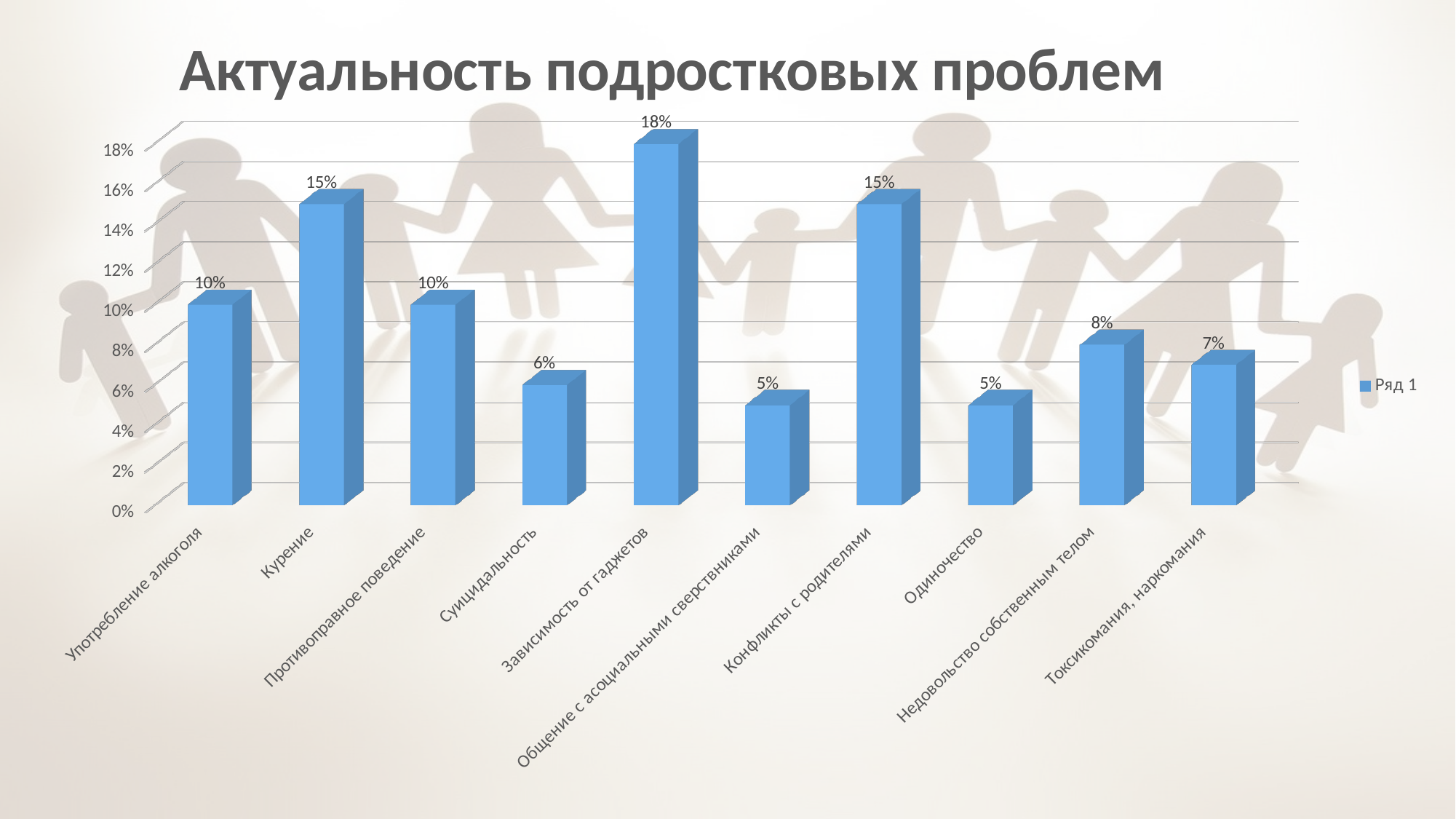
What kind of chart is shown on the slide? bar chart Is the value for Конфликты с родителями greater or less than 10%? greater Which category has the highest value? Зависимость от гаджетов What is the title of the chart? Актуальность подростковых проблем What is the difference between the values for Курение and Употребление алкоголя? 5% What is the value for Суицидальность? 6% What is the value for Зависимость от гаджетов? 18% What is the value for Недовольство собственным телом? 8% How many series does the legend list? 1 What is the name of the series in the legend? Ряд 1 Which is larger, the value for Одиночество or the value for Токсикомания, наркомания? Токсикомания, наркомания How many categories are shown on the x axis? 10